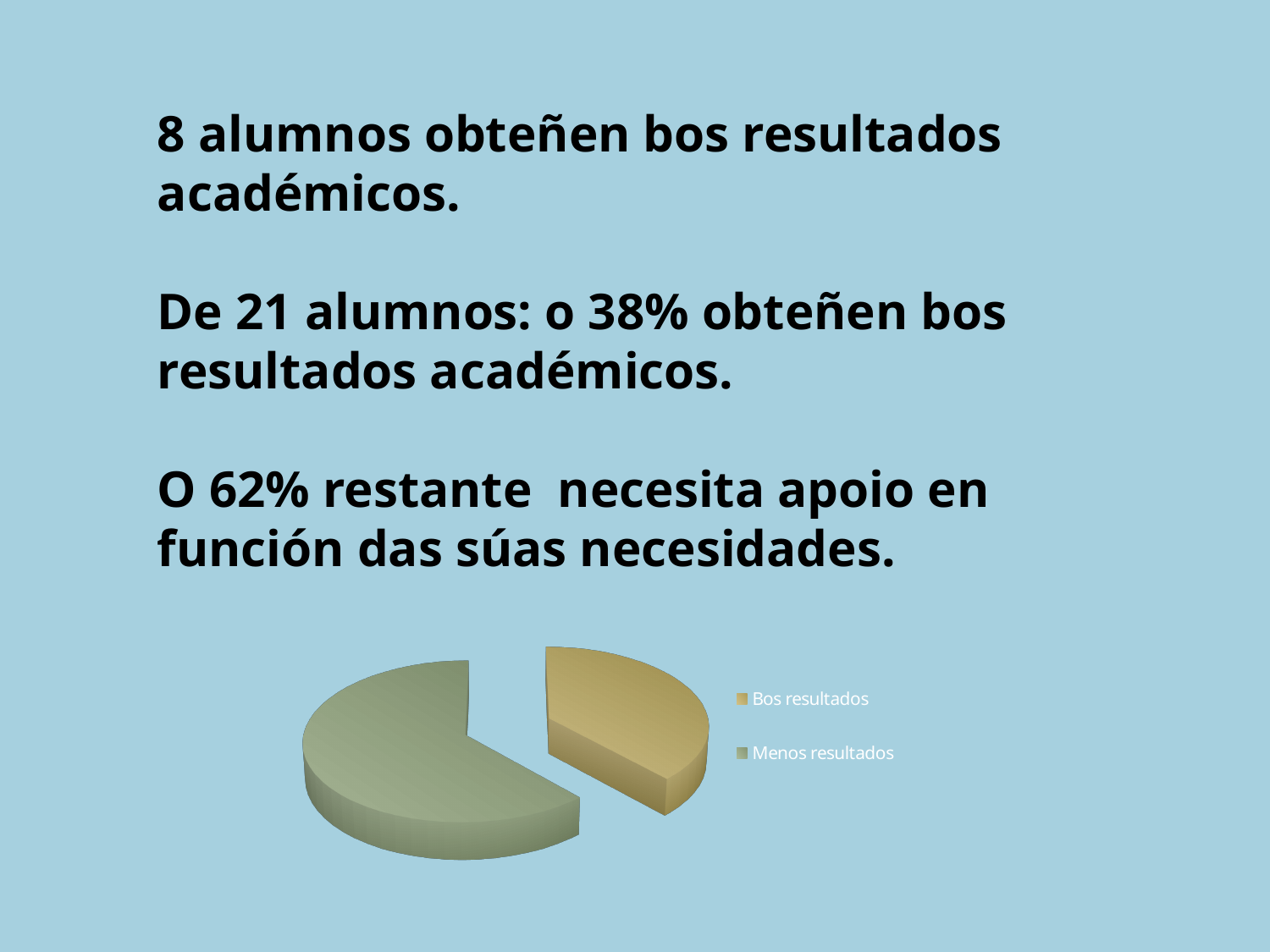
How many slices does the pie chart have? 2 Which slice of the pie chart is the smallest? Bos resultados Which slice of the pie chart is the largest? Menos resultados How many entries does the legend of the pie chart list? 2 What are the two legend entries of the pie chart? Bos resultados, Menos resultados What colour is the Bos resultados slice in the pie chart? gold Which slice is larger in the pie chart, Bos resultados or Menos resultados? Menos resultados What kind of chart is shown on the slide? pie chart